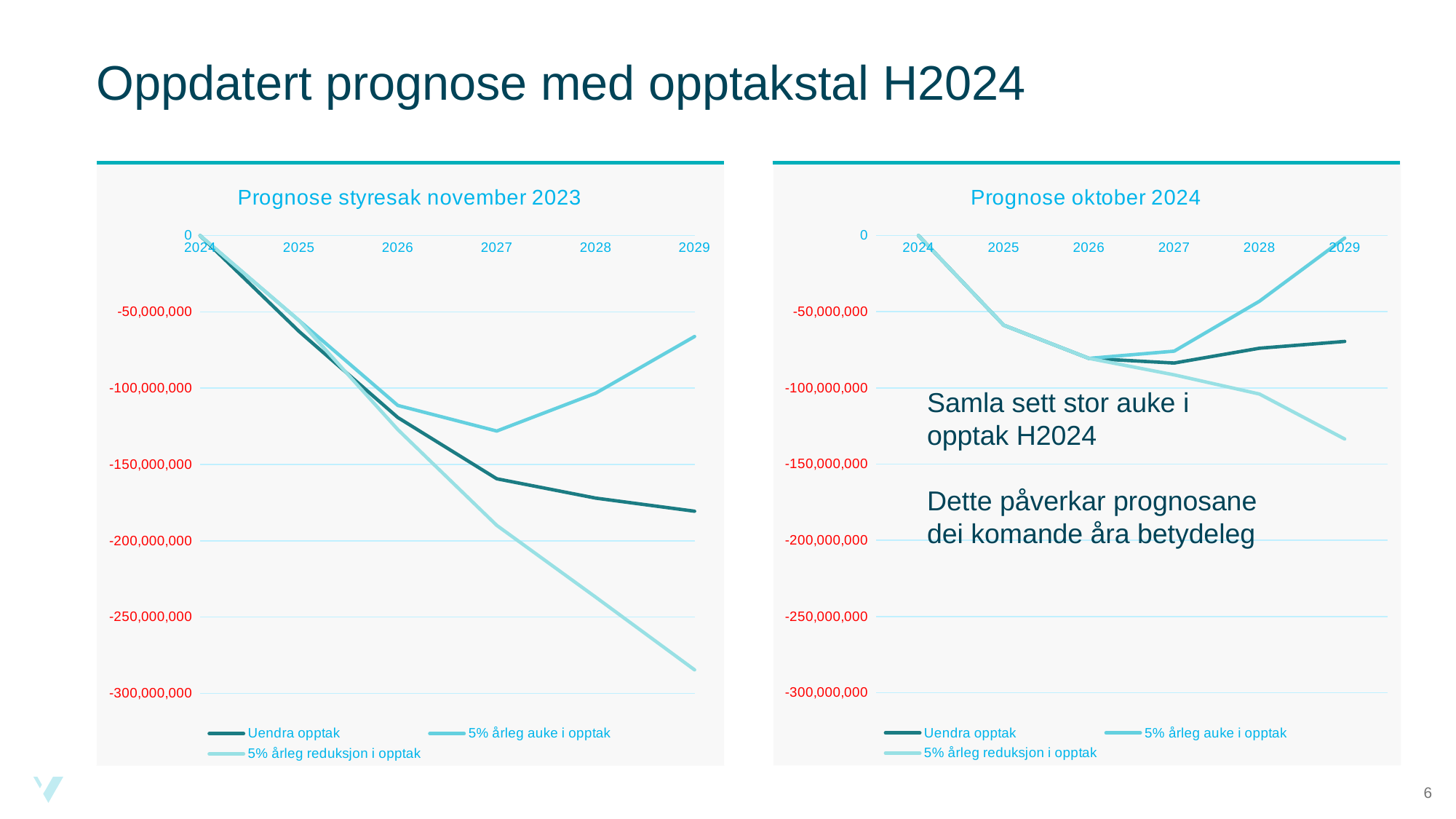
In the 'Prognose oktober 2024' chart, does the '5% årleg auke i opptak' series rise or fall from 2027 to 2029? rise How many series does the legend of the 'Prognose oktober 2024' chart list? 3 In the 'Prognose styresak november 2023' chart, is the value for '5% årleg reduksjon i opptak' in 2029 greater or less than -250,000,000? less How many years are shown on the x axis of the 'Prognose styresak november 2023' chart? 6 In the 'Prognose oktober 2024' chart, is the value for 'Uendra opptak' in 2029 greater or less than -100,000,000? greater In the 'Prognose styresak november 2023' chart, which series has the lowest value in 2029? 5% årleg reduksjon i opptak What is the title of the chart on the right side of the slide? Prognose oktober 2024 In the 'Prognose styresak november 2023' chart, is the value for '5% årleg auke i opptak' in 2029 greater or less than -100,000,000? greater In the 'Prognose oktober 2024' chart, which series has the highest value in 2029? 5% årleg auke i opptak In the 'Prognose styresak november 2023' chart, which is larger in 2028: 'Uendra opptak' or '5% årleg auke i opptak'? 5% årleg auke i opptak What kind of chart is the 'Prognose styresak november 2023' chart? line chart